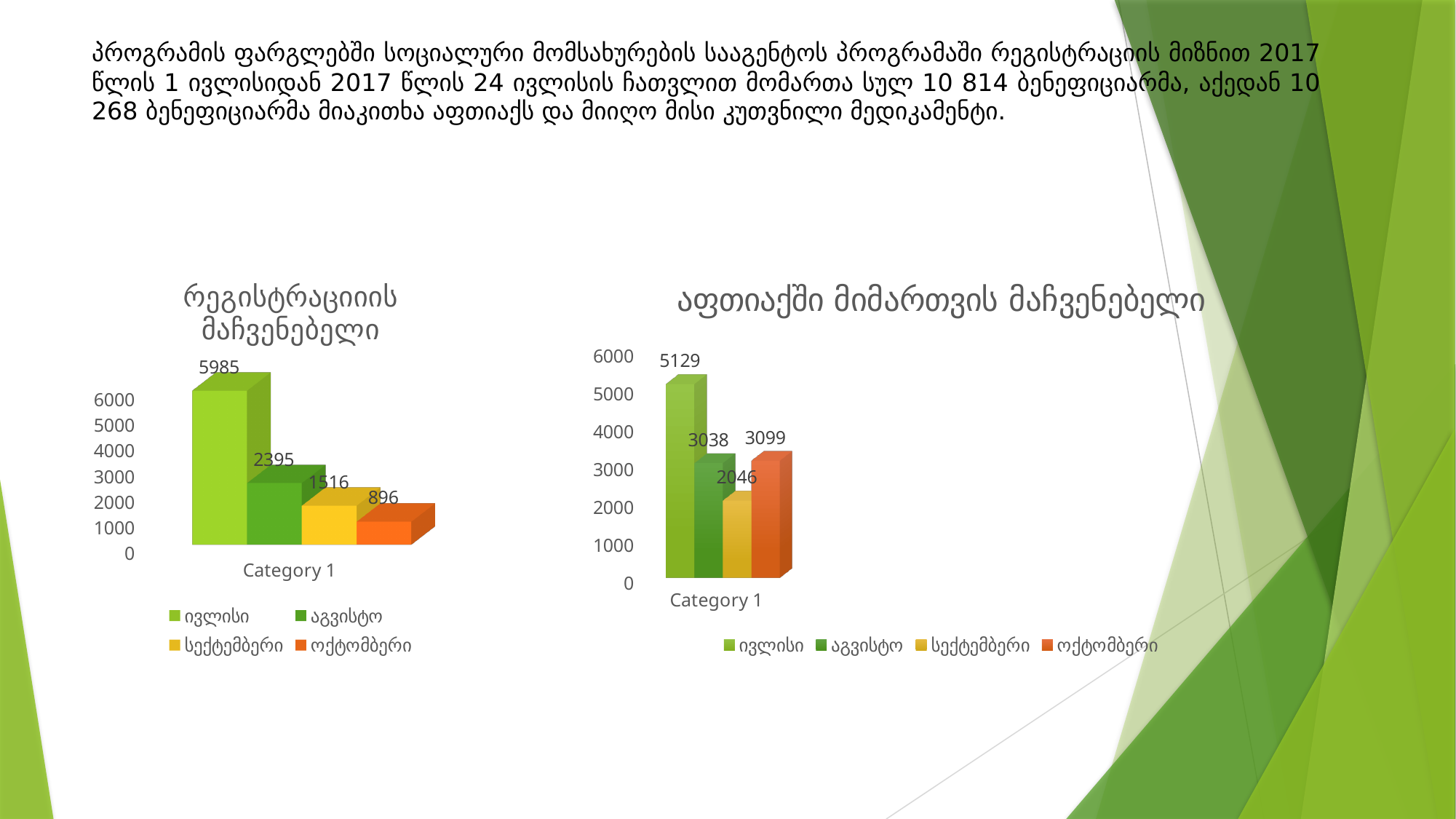
In the right chart (აფთიაქში მიმართვის მაჩვენებელი), what is the value for სექტემბერი? 2046 In the right chart (აფთიაქში მიმართვის მაჩვენებელი), what is the value for ოქტომბერი? 3099 In the left chart (რეგისტრაციიის მაჩვენებელი), what is the difference between ივლისი and აგვისტო? 3590 Which is larger: the value for აგვისტო in the left chart or the value for აგვისტო in the right chart? the right chart (3038) In the right chart (აფთიაქში მიმართვის მაჩვენებელი), which series has the highest value? ივლისი How many series does the legend of the right chart (აფთიაქში მიმართვის მაჩვენებელი) list? 4 In the left chart (რეგისტრაციიის მაჩვენებელი), what is the value for ოქტომბერი? 896 In the right chart (აფთიაქში მიმართვის მაჩვენებელი), what is the difference between ივლისი and სექტემბერი? 3083 In the left chart (რეგისტრაციიის მაჩვენებელი), which series has the lowest value? ოქტომბერი In the left chart (რეგისტრაციიის მაჩვენებელი), what is the value for ივლისი? 5985 In the left chart (რეგისტრაციიის მაჩვენებელი), do the values rise or fall from ივლისი to ოქტომბერი? fall What type of chart is the left chart (რეგისტრაციიის მაჩვენებელი)? bar chart